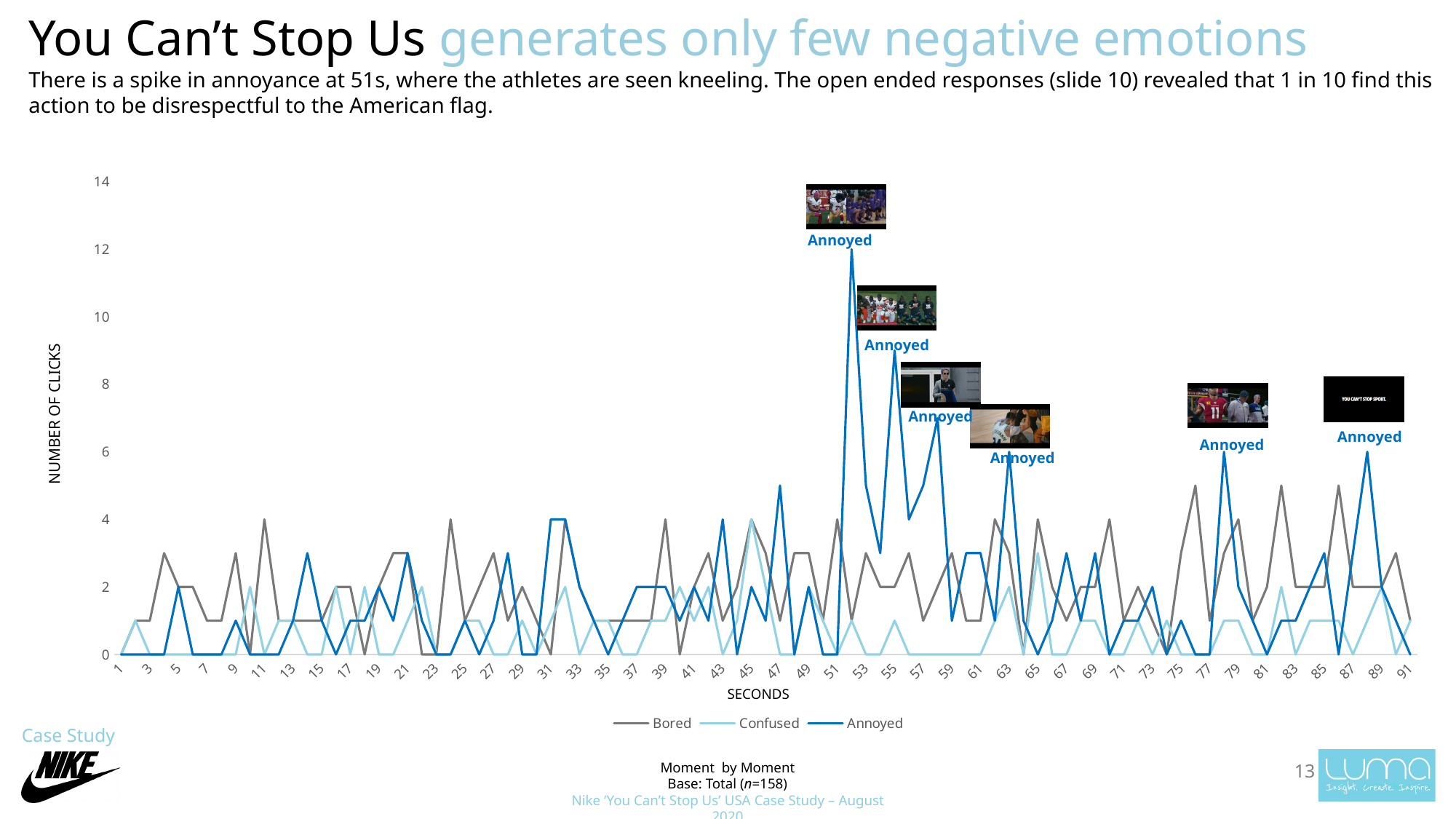
Which series has the lowest peak value across the chart? Confused At the large spike just after 51 seconds, which series is higher, Annoyed or Bored? Annoyed Is the highest value of the Bored line greater or less than 6? less Is the highest value of the Annoyed line greater or less than 10? greater What are the three series named in the legend? Bored, Confused, Annoyed Which series reaches the highest value anywhere on the chart? Annoyed Is the highest value of the Confused line greater or less than 6? less What kind of chart is shown on the slide? line chart How many series does the legend list? 3 What is the title of the vertical axis? NUMBER OF CLICKS